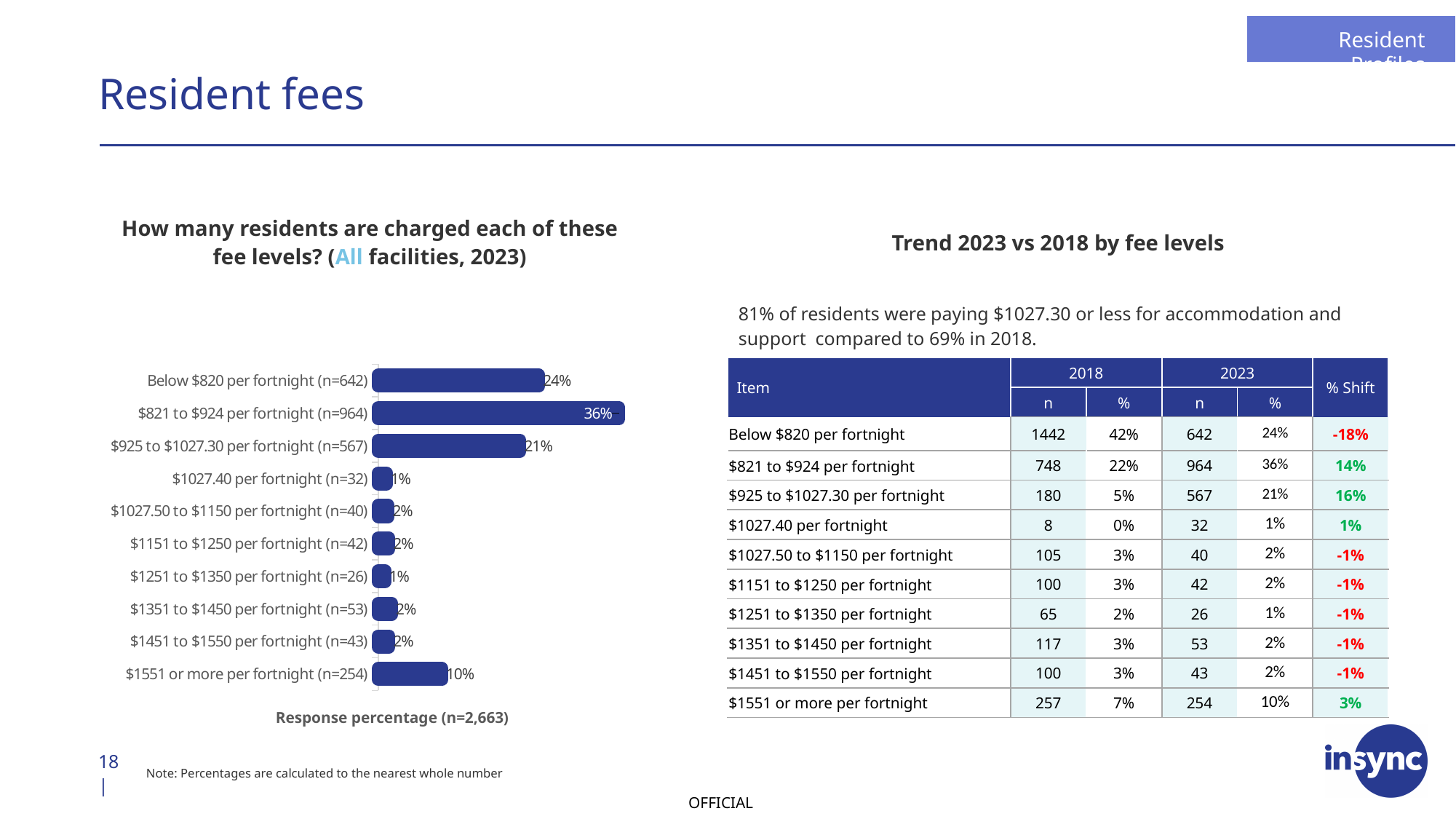
What is the title of the bar chart? How many residents are charged each of these fee levels? (All facilities, 2023) What percentage of residents are charged $925 to $1027.30 per fortnight? 21% What is the total response count (n) shown in the bar chart's axis label? n=2,663 How many fee level categories are shown in the bar chart? 10 What percentage of residents are charged below $820 per fortnight? 24% Which is larger: the percentage for $1551 or more per fortnight or the percentage for $925 to $1027.30 per fortnight? $925 to $1027.30 per fortnight What percentage of residents are charged $1551 or more per fortnight? 10% What is the difference in percentage points between the $925 to $1027.30 per fortnight bar and the $1551 or more per fortnight bar? 11% What percentage of residents are charged $821 to $924 per fortnight? 36% Which fee level has the highest response percentage? $821 to $924 per fortnight What is the difference in percentage points between the $821 to $924 per fortnight bar and the below $820 per fortnight bar? 12% What kind of chart is used to show the response percentages by fee level? Bar chart